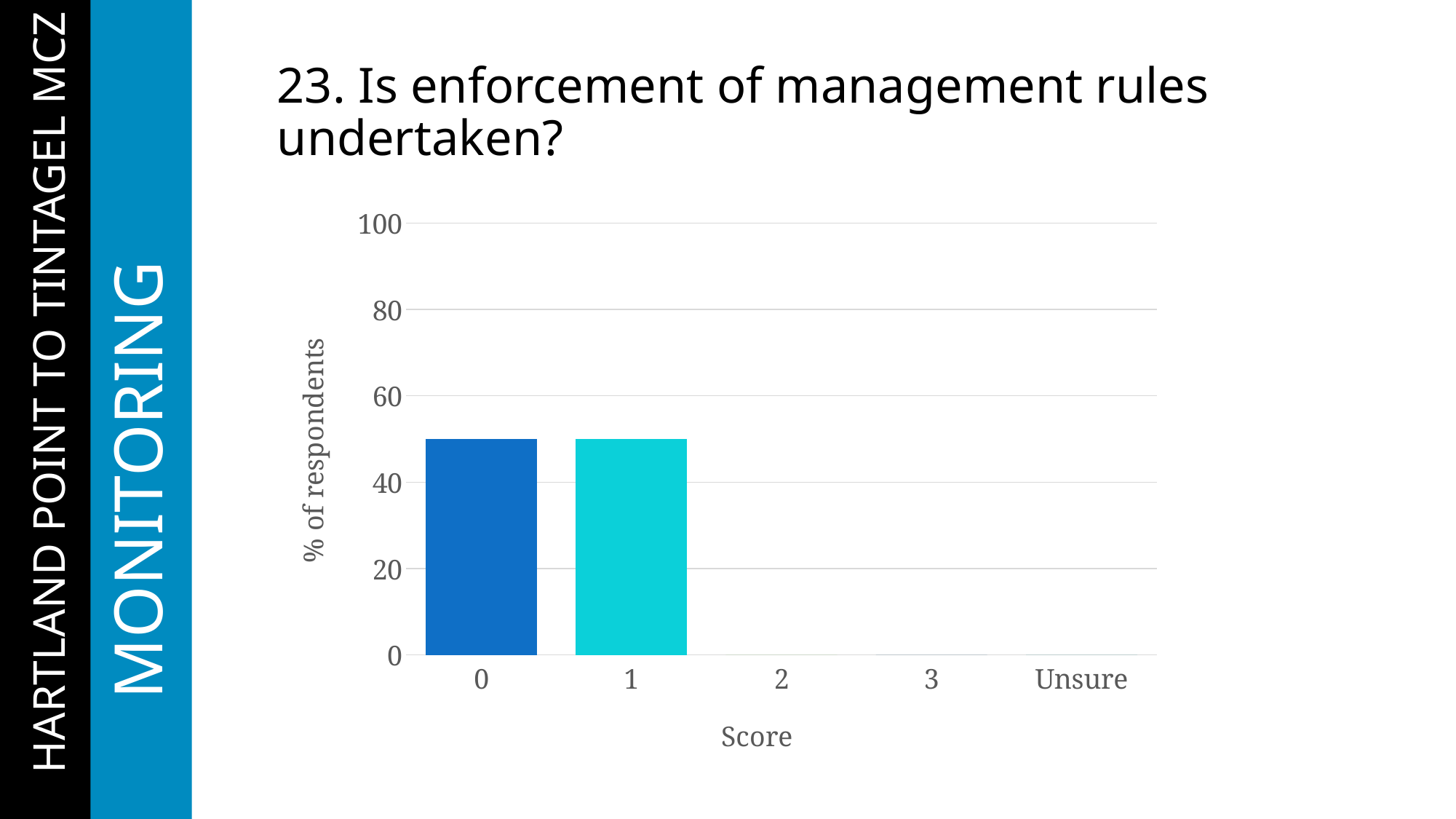
What is the value for score 2? 0 Is the value for score 0 greater or less than 60? less How many score categories are shown on the x axis of the chart? 5 What kind of chart is shown on the slide? bar chart Is the value for score 1 greater or less than 60? less What is the value for the Unsure category? 0 Is the value for score 0 greater or less than 40? greater Which is larger, the value for score 1 or the value for score 3? score 1 What is the label on the y axis of the chart? % of respondents How many score categories have a bar above zero? 2 What is the label on the x axis of the chart? Score What is the value for score 3? 0